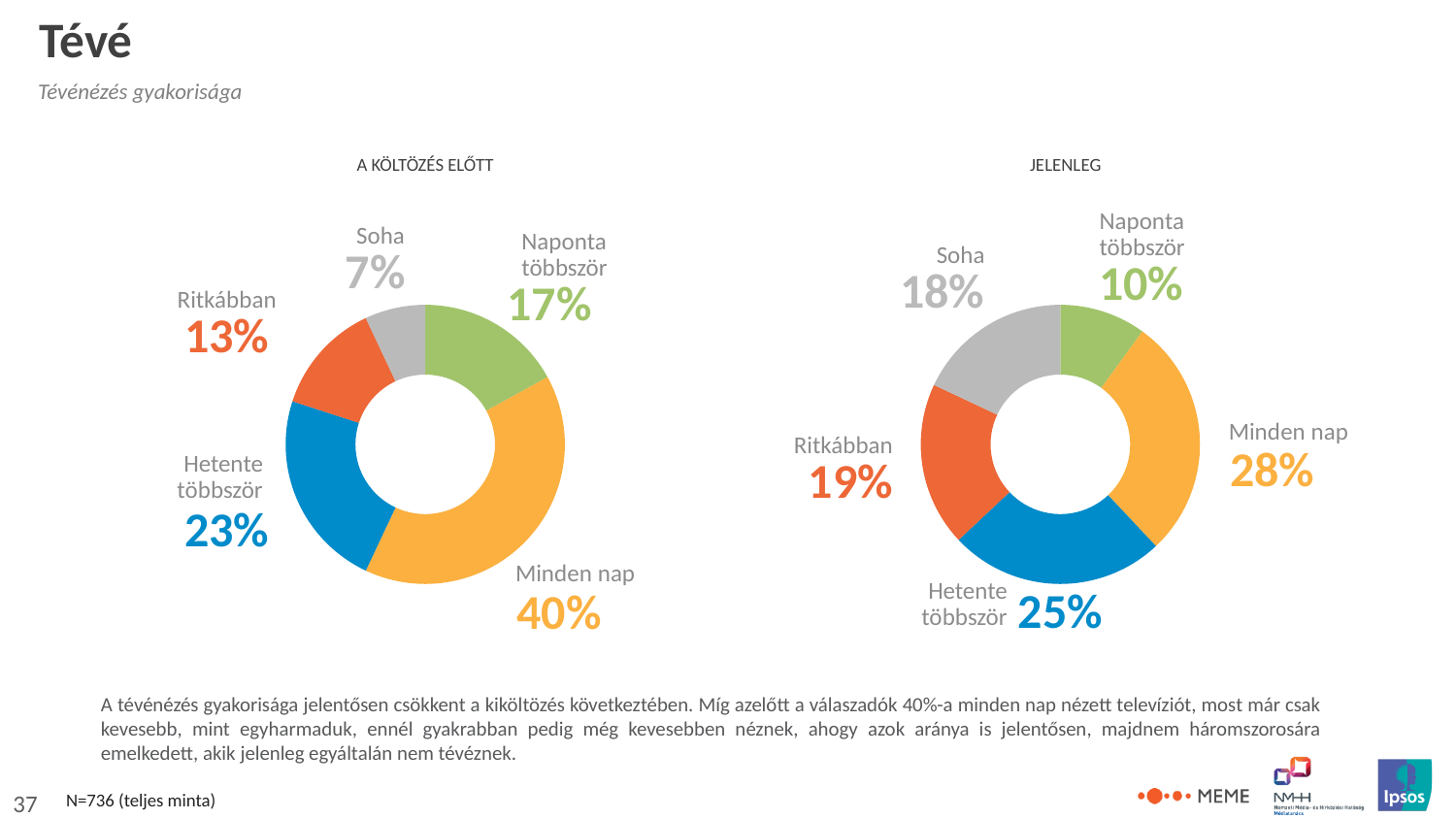
What type of chart is the "A KÖLTÖZÉS ELŐTT" chart? Donut (pie) chart In the "JELENLEG" chart, what is the difference between "Minden nap" and "Naponta többször"? 18 percentage points How many categories does the "JELENLEG" chart show? 5 In the "A KÖLTÖZÉS ELŐTT" chart, which category has the highest value? Minden nap In the "A KÖLTÖZÉS ELŐTT" chart, what colour is the "Hetente többször" slice? Blue In the "JELENLEG" chart, what is the value for "Hetente többször"? 25% In the "A KÖLTÖZÉS ELŐTT" chart, which category has the lowest value? Soha What is the difference between the "Minden nap" values in the "A KÖLTÖZÉS ELŐTT" chart and the "JELENLEG" chart? 12 percentage points In the "JELENLEG" chart, what is the value for "Soha"? 18% In the "A KÖLTÖZÉS ELŐTT" chart, what is the value for "Minden nap"? 40% Which is larger: "Soha" in the "A KÖLTÖZÉS ELŐTT" chart or "Soha" in the "JELENLEG" chart? JELENLEG In the "JELENLEG" chart, which category has the lowest value? Naponta többször